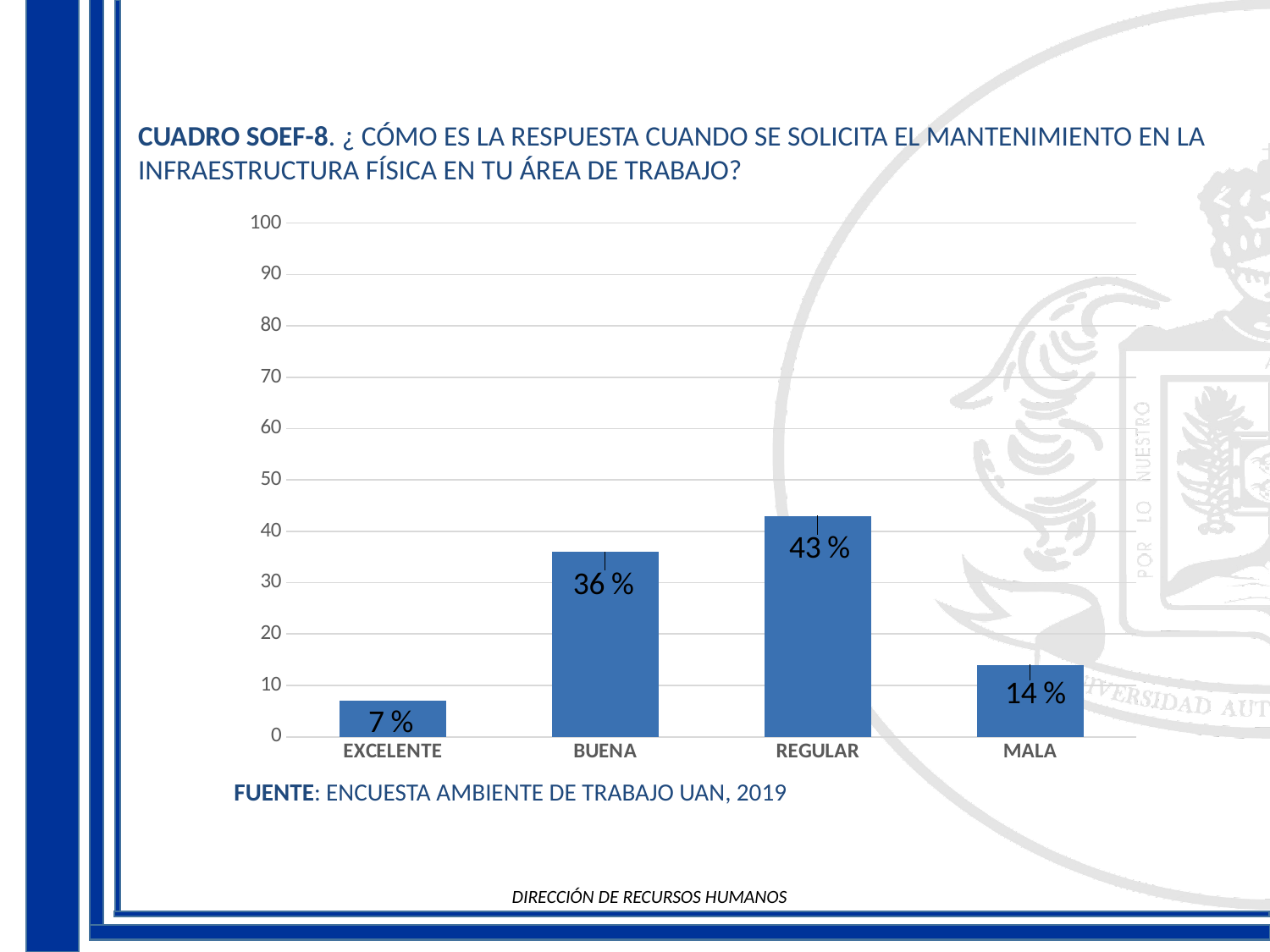
What is the value for REGULAR? 43 % What source is cited below the chart? ENCUESTA AMBIENTE DE TRABAJO UAN, 2019 What kind of chart is shown on the slide? bar chart What is the value for BUENA? 36 % What is the difference between the values for REGULAR and BUENA? 7 % Which category has the highest value? REGULAR What is the value for MALA? 14 % Which is larger, the value for MALA or the value for EXCELENTE? MALA Is the value for BUENA greater or less than 30? greater What is the value for EXCELENTE? 7 % How many categories are shown on the x axis? 4 Which category has the lowest value? EXCELENTE